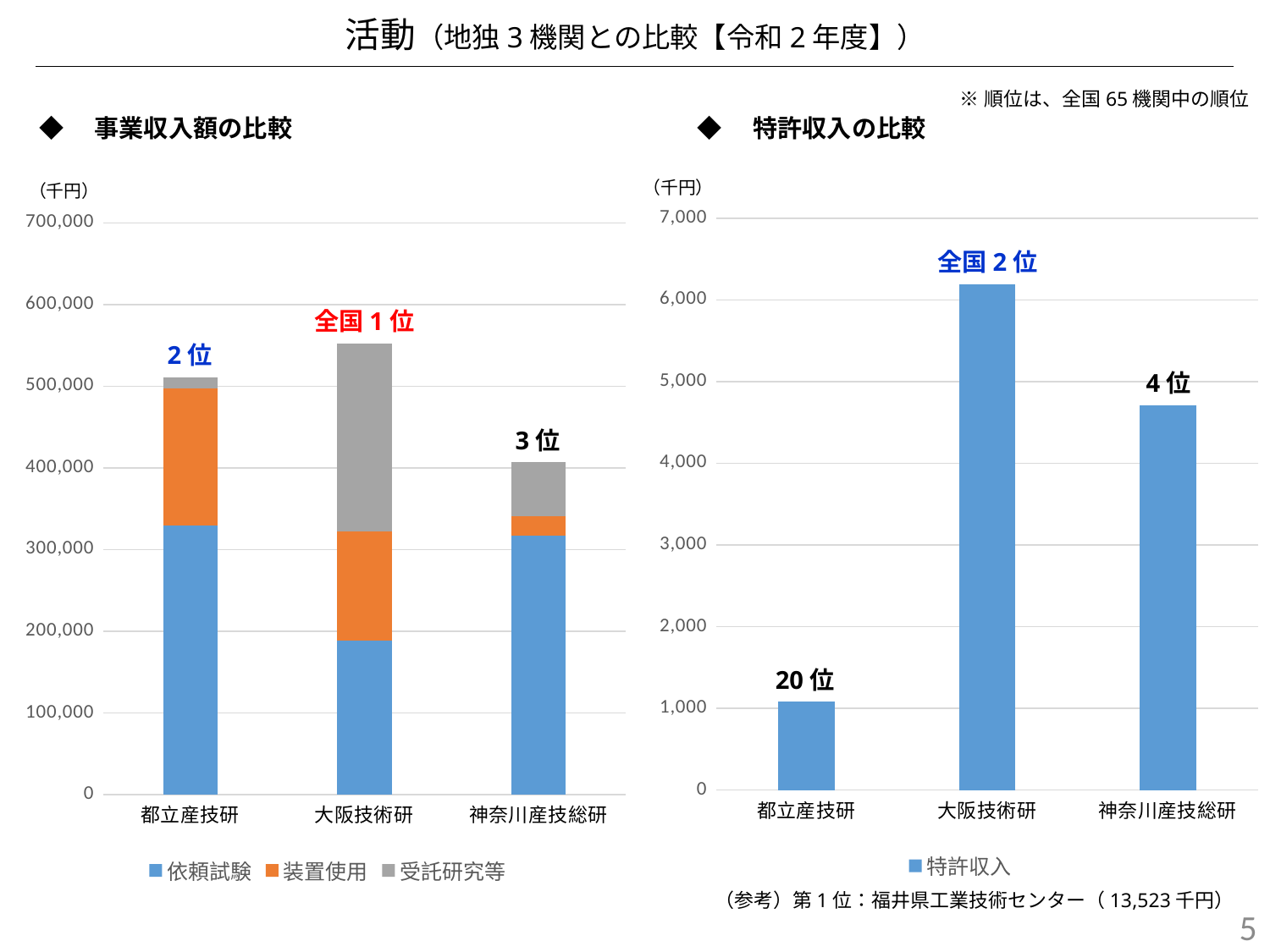
In the right chart (特許収入の比較), which institution has the lowest value? 都立産技研 In the left chart (事業収入額の比較), which has the larger 依頼試験 segment, 都立産技研 or 大阪技術研? 都立産技研 In the right chart (特許収入の比較), how many institutions are plotted? 3 In the right chart (特許収入の比較), is the value for 大阪技術研 greater or less than 6,000? greater In the left chart (事業収入額の比較), which institution has the highest total bar? 大阪技術研 In the left chart (事業収入額の比較), what rank label is shown above the bar for 大阪技術研? 全国1位 In the right chart (特許収入の比較), what rank label is shown above the bar for 都立産技研? 20位 In the left chart (事業収入額の比較), is the total for 大阪技術研 greater or less than 600,000? less In the left chart (事業収入額の比較), how many series does the legend list? 3 In the left chart (事業収入額の比較), is the total for 神奈川産技総研 greater or less than 500,000? less In the left chart (事業収入額の比較), which institution has the lowest total bar? 神奈川産技総研 What kind of chart is the left chart titled 事業収入額の比較? Stacked bar chart